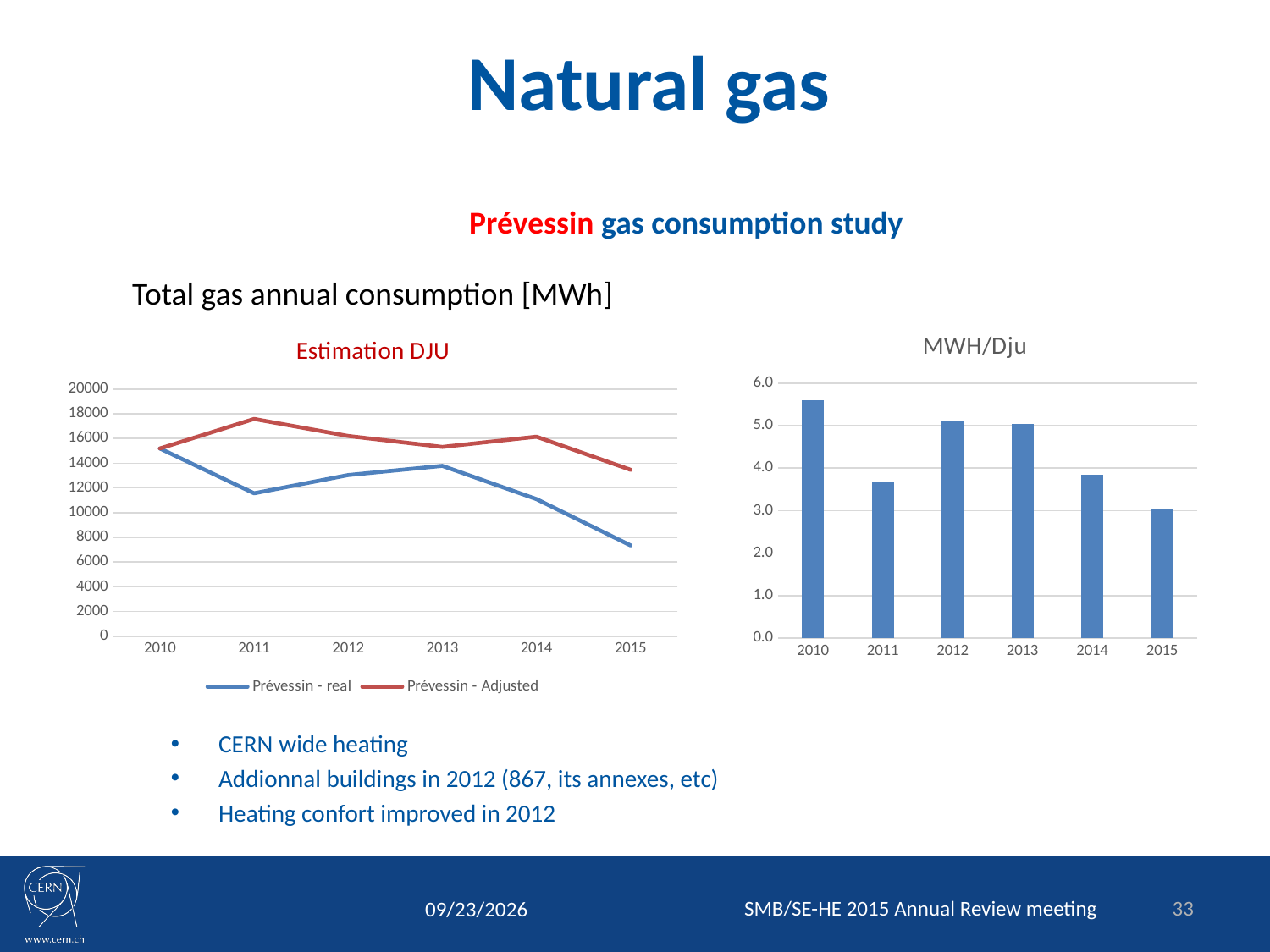
In the "Estimation DJU" chart, does the Prévessin - real series rise or fall from 2013 to 2015? fall In the "MWH/Dju" chart, is the value for 2015 greater or less than 4.0? less In the "Estimation DJU" chart, is the Prévessin - Adjusted value for 2011 greater or less than 16000? greater In the "Estimation DJU" chart, is the Prévessin - real value for 2015 greater or less than 8000? less What type of chart is the "MWH/Dju" chart? bar chart How many years are shown on the x axis of the "MWH/Dju" chart? 6 In the "MWH/Dju" chart, which year has the highest value? 2010 What type of chart is the "Estimation DJU" chart? line chart In the "Estimation DJU" chart, which series is higher in 2015, Prévessin - real or Prévessin - Adjusted? Prévessin - Adjusted In the "MWH/Dju" chart, which year has the lowest value? 2015 How many series does the legend of the "Estimation DJU" chart list? 2